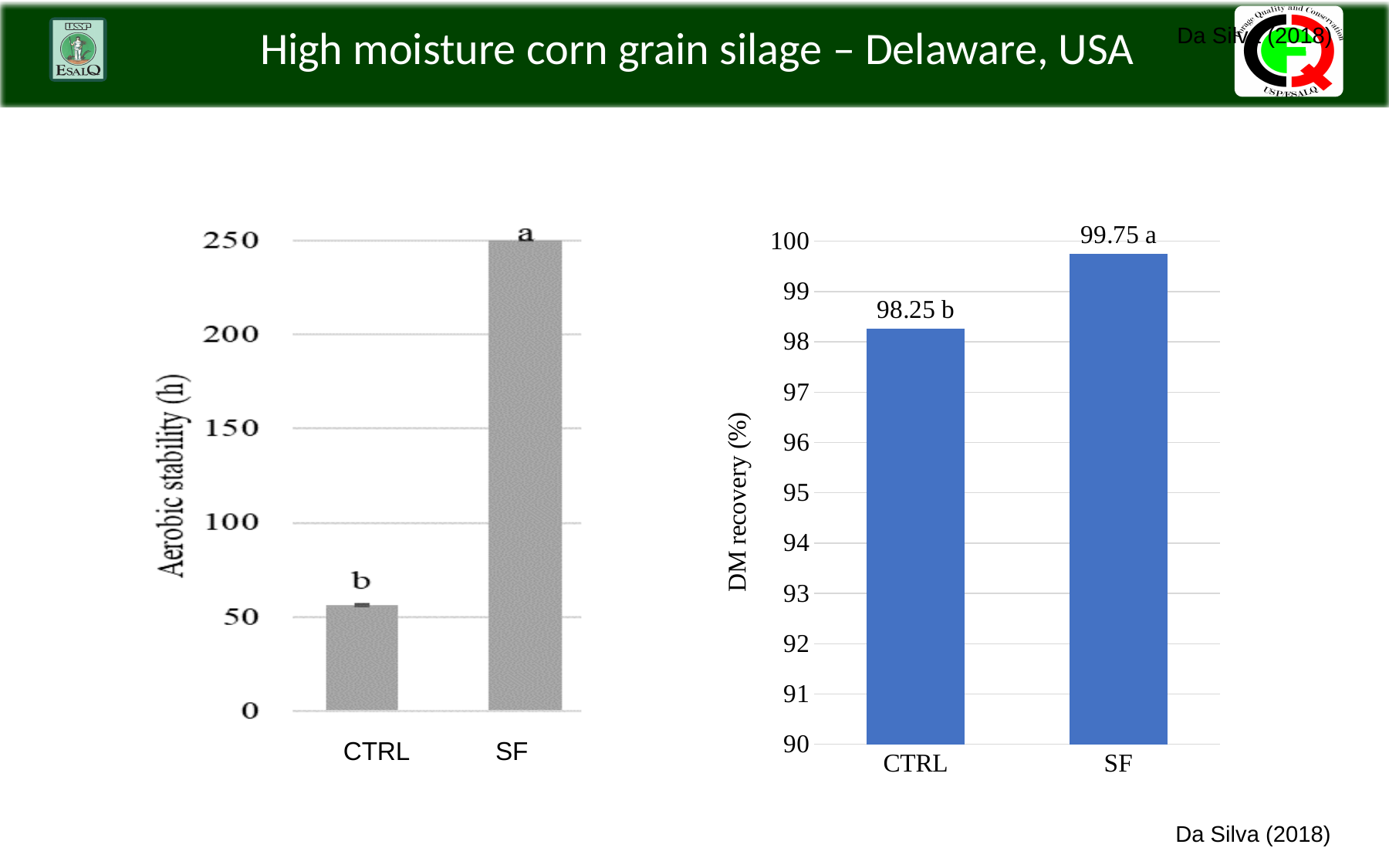
In the DM recovery (%) chart on the right, how many bars are plotted? 2 What is the y-axis label of the chart on the right of the slide? DM recovery (%) In the Aerobic stability (h) chart on the left, is the value for SF greater or less than 200? greater In the DM recovery (%) chart on the right, what is the value for CTRL? 98.25 In the DM recovery (%) chart on the right, what is the value for SF? 99.75 What kind of chart is the chart on the left of the slide? Bar chart In the Aerobic stability (h) chart on the left, is the value for SF larger than the value for CTRL? Yes In the Aerobic stability (h) chart on the left, which category has the lowest value? CTRL In the Aerobic stability (h) chart on the left, is the value for CTRL greater or less than 100? less In the DM recovery (%) chart on the right, what is the difference between the SF and CTRL values? 1.5 In the DM recovery (%) chart on the right, which category has the higher value? SF In the Aerobic stability (h) chart on the left, how many categories are shown on the x axis? 2